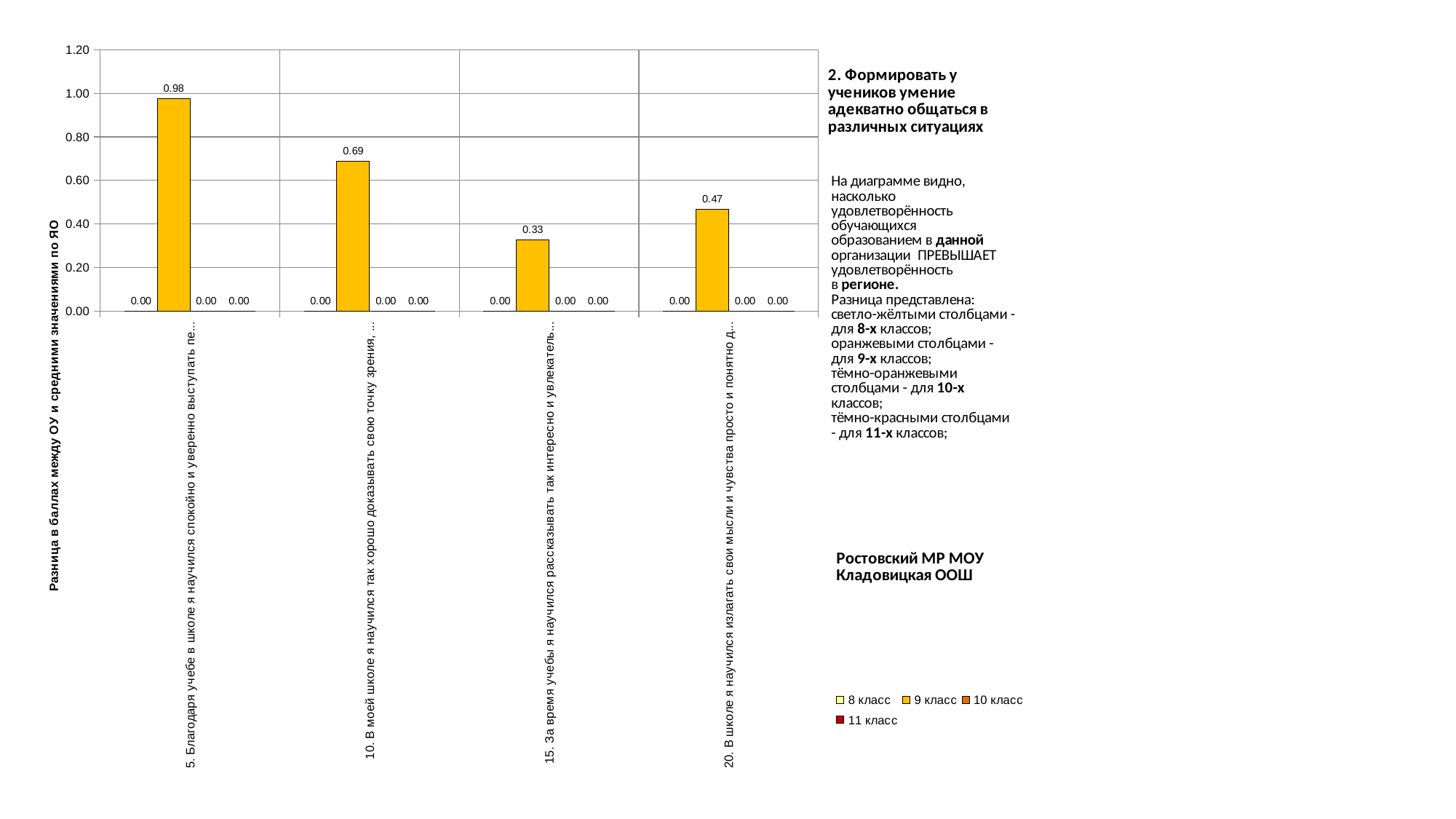
For which statement is the 9 класс value lowest? 15. За время учебы я научился рассказывать так интересно и увлекатель... What type of chart is shown on the slide? bar chart What is the value for 8 класс for statement 5? 0.00 What is the value for 9 класс for statement 20 ("В школе я научился излагать свои мысли и чувства просто и понятно...")? 0.47 Which is larger for 9 класс: the value for statement 15 or the value for statement 20? statement 20 What is the value for 9 класс for statement 10 ("В моей школе я научился так хорошо доказывать свою точку зрения...")? 0.69 What is the difference between the 9 класс values for statement 5 and statement 10? 0.29 What is the value for 9 класс for statement 5 ("Благодаря учебе в школе я научился спокойно и уверенно выступать...")? 0.98 How many series does the legend list? 4 How many categories (statements) are plotted on the x axis? 4 For which statement is the 9 класс value highest? 5. Благодаря учебе в школе я научился спокойно и уверенно выступать... What is the value for 9 класс for statement 15 ("За время учебы я научился рассказывать так интересно и увлекатель...")? 0.33